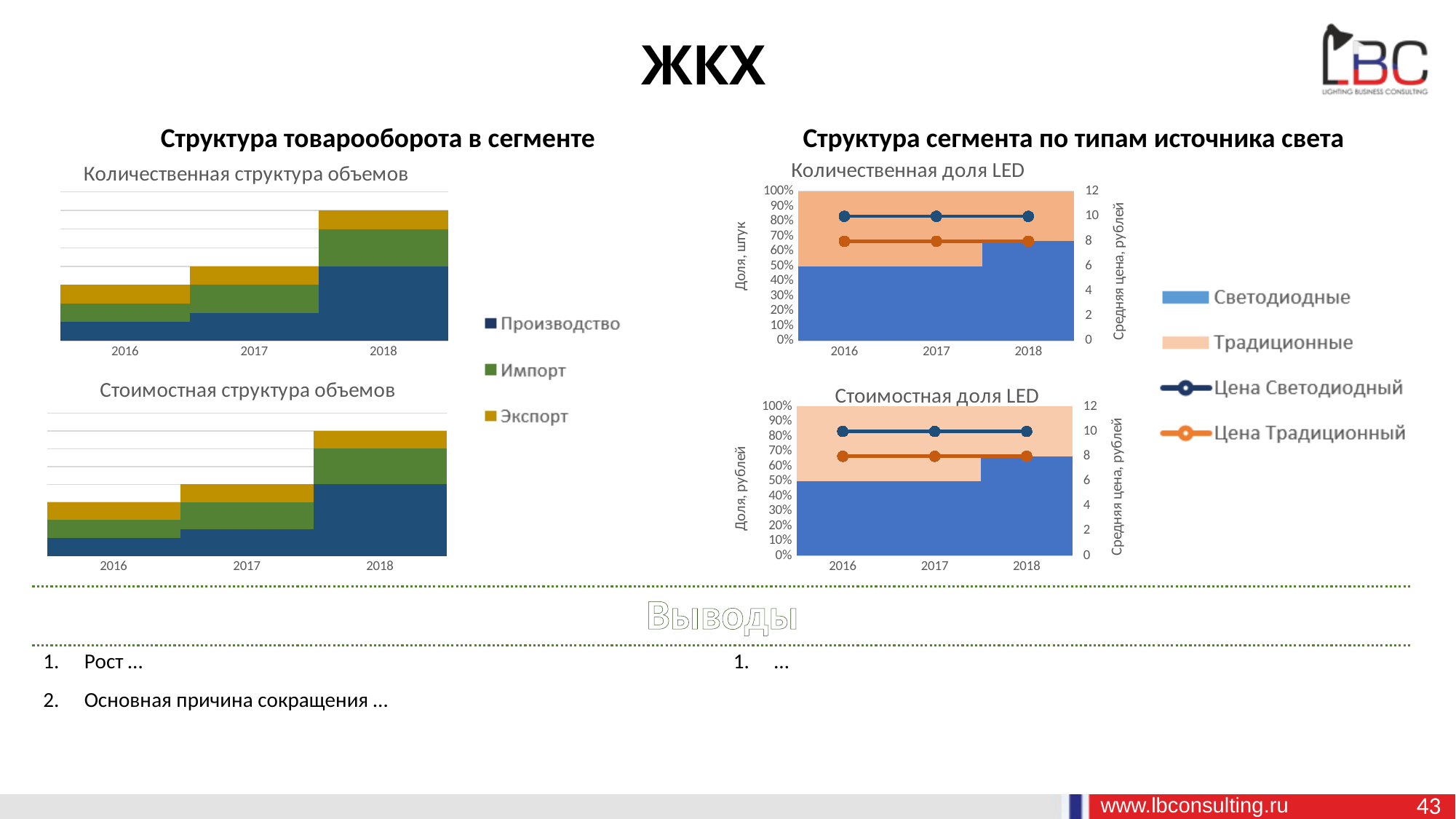
How many series does the legend list for the "Структура товарооборота в сегменте" charts? 3 In the "Количественная доля LED" chart, which is higher in 2016: "Цена Светодиодный" or "Цена Традиционный"? Цена Светодиодный In the "Стоимостная доля LED" chart, does the share of "Светодиодные" rise or fall from 2016 to 2018? Rise In the "Количественная доля LED" chart, what is the value of "Цена Светодиодный" in 2017 on the right axis? 10 In the "Количественная структура объемов" chart, which year has the highest total bar? 2018 What kind of chart is the "Количественная структура объемов" chart? Stacked bar chart How many years are shown on the x axis of the "Стоимостная структура объемов" chart? 3 How many series does the legend list for the "Структура сегмента по типам источника света" charts? 4 In the "Стоимостная доля LED" chart, what is the difference between "Цена Светодиодный" and "Цена Традиционный" in 2016? 2 In the "Стоимостная структура объемов" chart, do the total bar heights rise or fall from 2016 to 2018? Rise In the "Количественная доля LED" chart, is the share of "Светодиодные" in 2018 greater or less than 60%? greater In the "Стоимостная доля LED" chart, what is the value of "Цена Традиционный" in 2018 on the right axis? 8